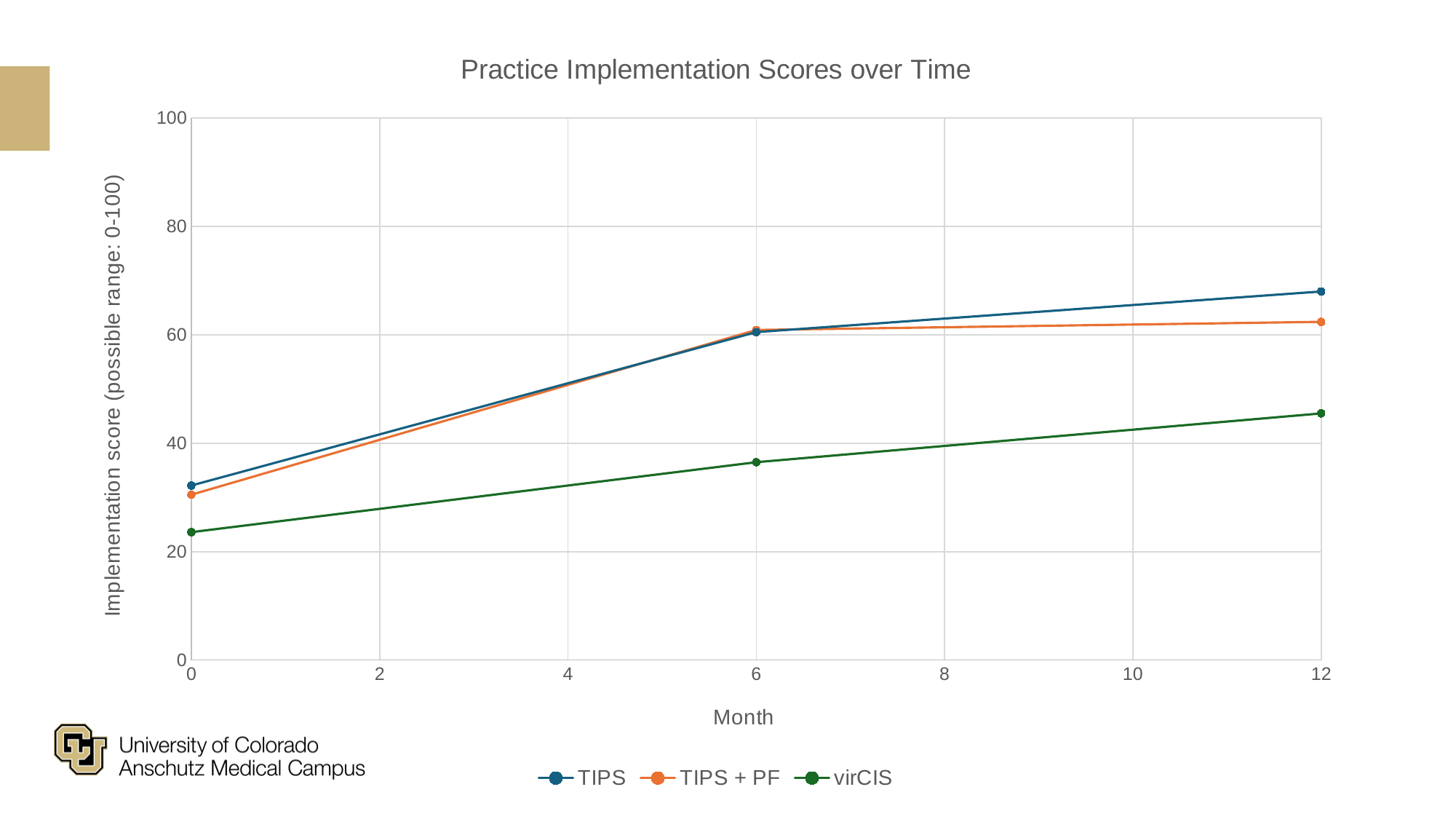
Do the virCIS scores rise or fall from month 0 to month 12? rise At month 12, which is larger: the score for TIPS or the score for TIPS + PF? TIPS What is the title of the chart? Practice Implementation Scores over Time Is the value for virCIS at month 0 greater or less than 40? less Which series has the lowest implementation score at month 12? virCIS Is the value for virCIS at month 12 greater or less than 40? greater What kind of chart is shown on the slide? line chart Which series has the lowest implementation score at month 0? virCIS Is the value for TIPS at month 12 greater or less than 60? greater How many series does the legend list? 3 How many data points are plotted for the virCIS series? 3 Which series has the highest implementation score at month 12? TIPS